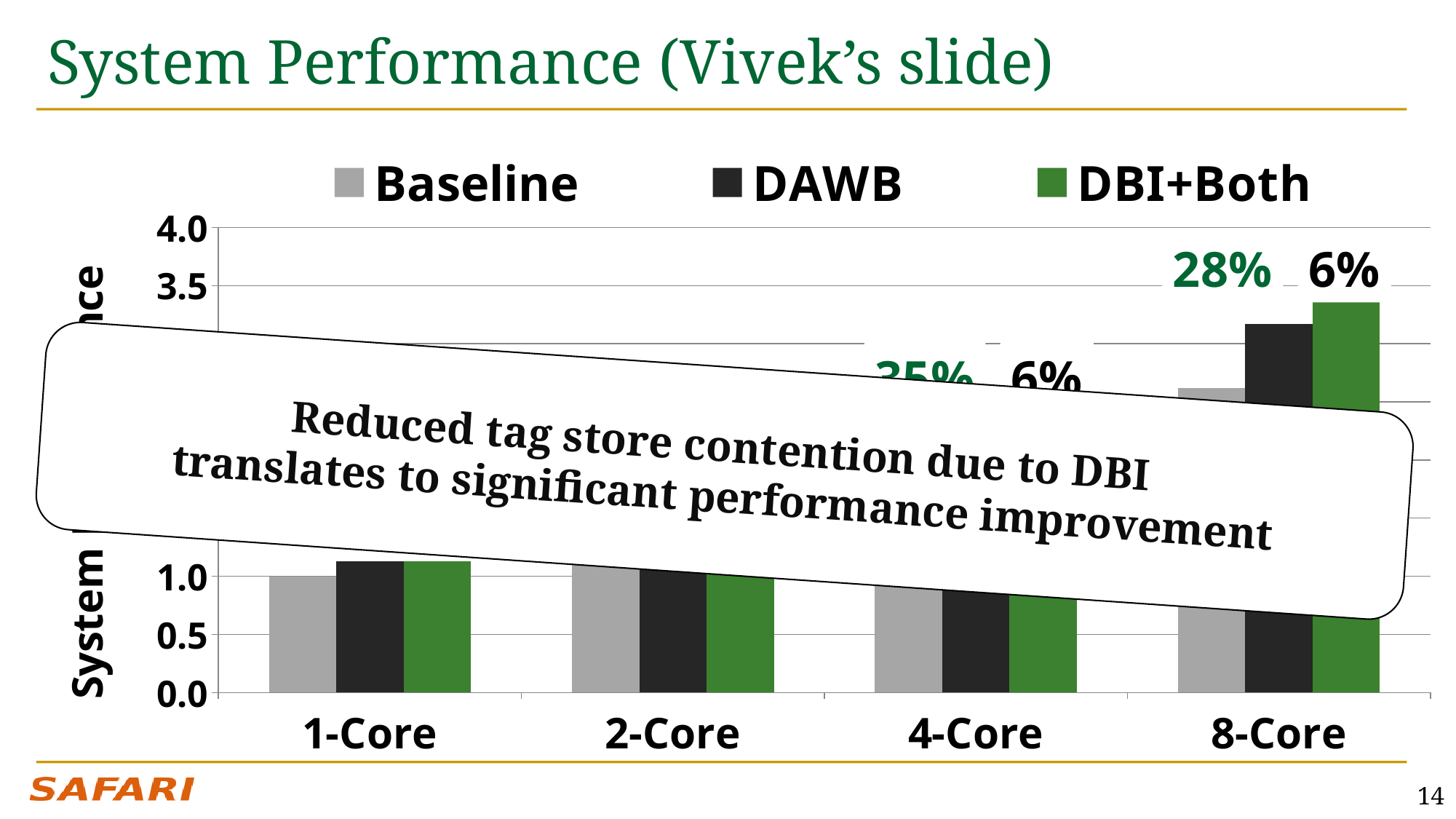
What is the Baseline value for 1-Core? 1.0 Is the DBI+Both value for 8-Core greater or less than 3.0? greater For 8-Core, which is larger: the DAWB bar or the DBI+Both bar? DBI+Both What is the highest tick value shown on the y axis? 4.0 How many series does the legend list? 3 Which is larger: the Baseline value for 8-Core or the Baseline value for 1-Core? 8-Core What green percentage label is printed above the 8-Core group? 28% What are the three series named in the legend? Baseline, DAWB, DBI+Both How many core-count categories are shown on the x axis? 4 Is the Baseline value for 8-Core greater or less than 2.0? greater What kind of chart is shown on the slide? bar chart Which category has the highest DBI+Both value? 8-Core